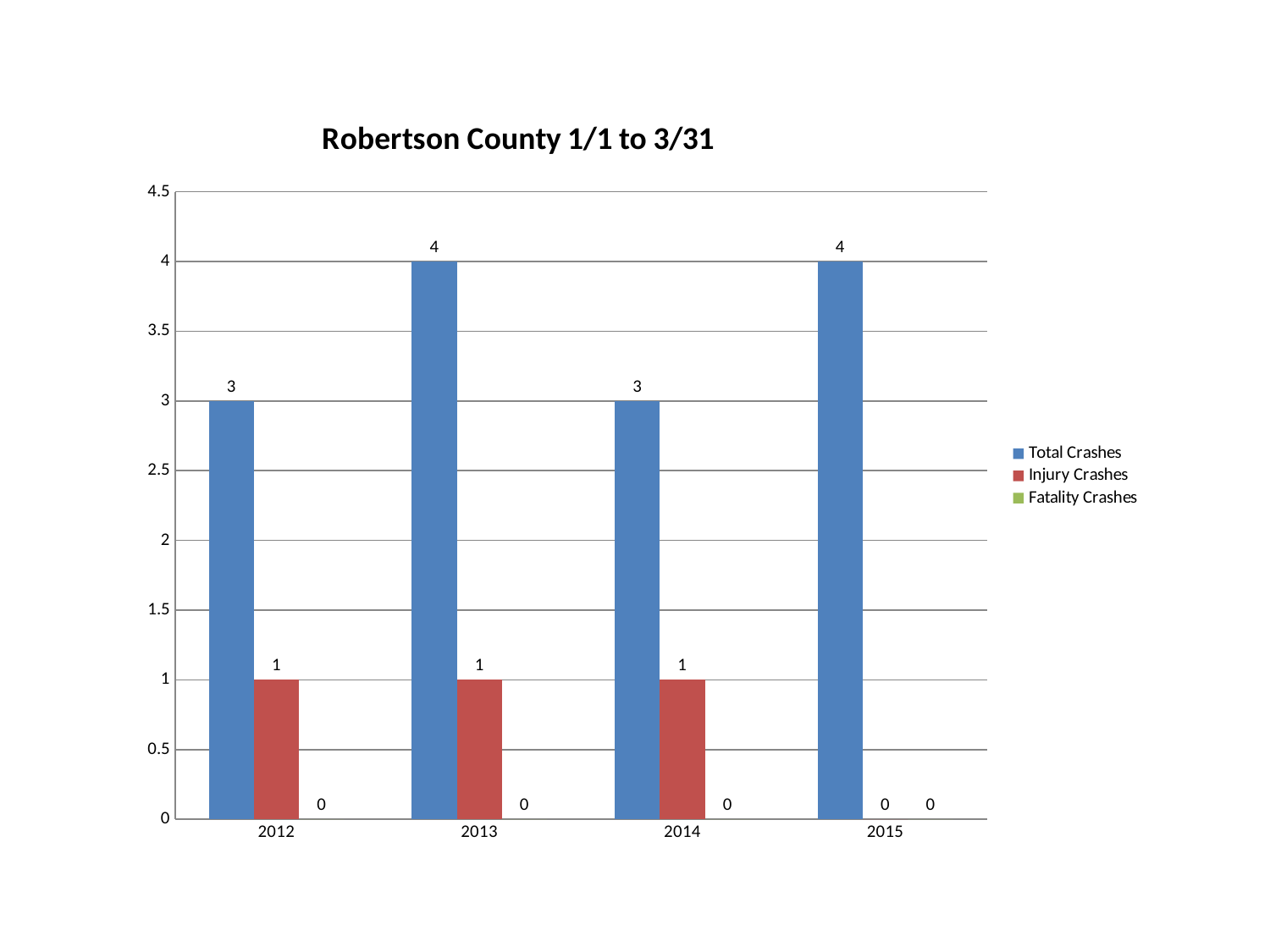
What is the difference between Total Crashes and Injury Crashes in 2012? 2 Which year has the lowest value for Injury Crashes? 2015 What is the value of Total Crashes for 2013? 4 What is the value of Fatality Crashes for 2012? 0 What is the value of Injury Crashes for 2014? 1 What is the difference in Total Crashes between 2013 and 2014? 1 Which is larger, Total Crashes in 2014 or Total Crashes in 2015? Total Crashes in 2015 What kind of chart is shown on the slide? Bar chart How many series does the legend list? 3 What is the title of the chart? Robertson County 1/1 to 3/31 What is the value of Injury Crashes for 2015? 0 How many years are shown on the x axis? 4